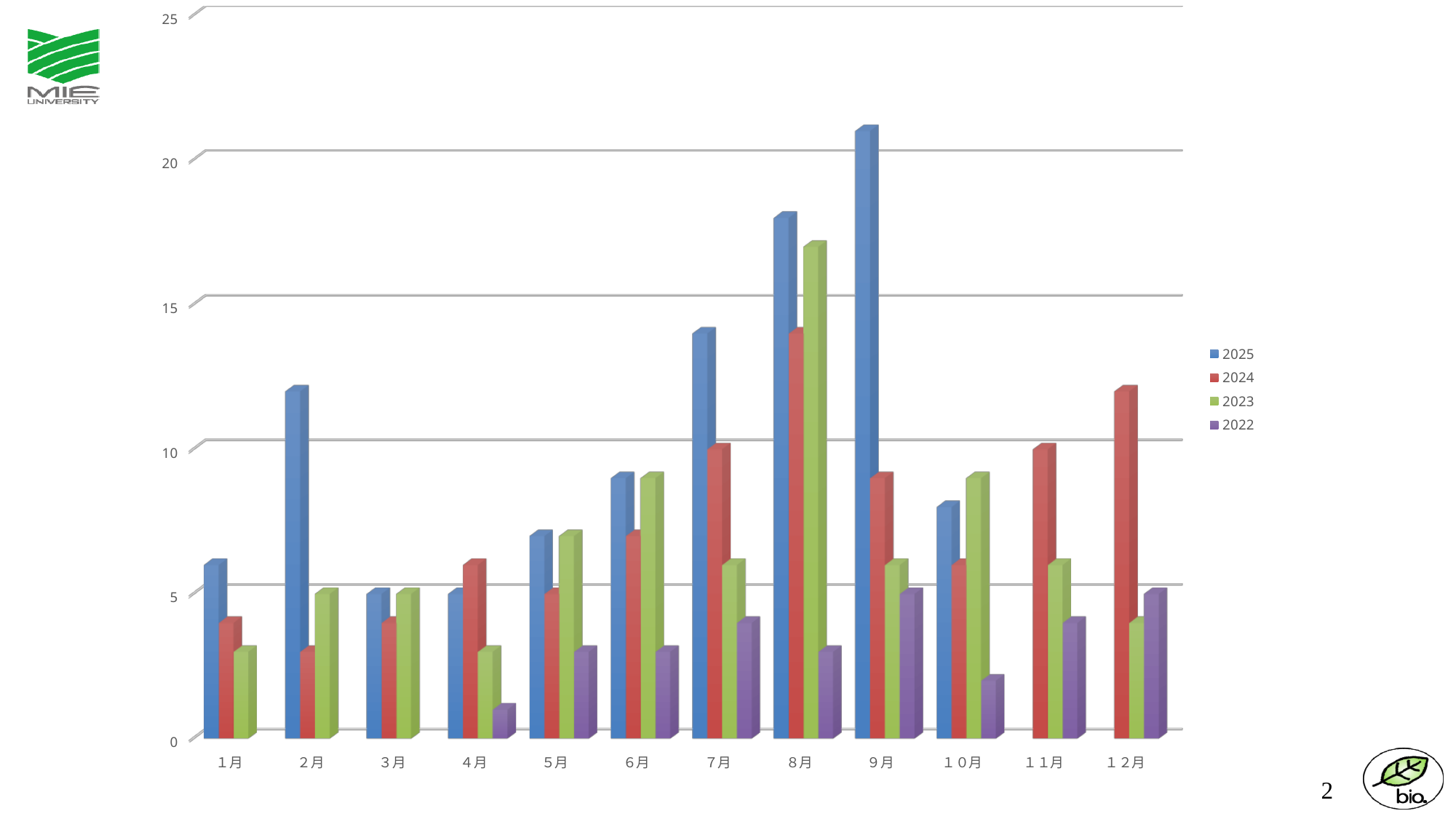
Is the value for 2025 in 9月 greater or less than 20? greater Which month has the highest value for the 2023 series? 8月 Which month has the highest value for the 2025 series? 9月 Is the value for 2022 in 10月 greater or less than 5? less In 2月, which series has the larger value, 2025 or 2024? 2025 Which month has the lowest value for the 2022 series? 4月 How many series does the legend list? 4 Is the value for 2024 in 12月 greater or less than 10? greater What kind of chart is shown on the slide? bar chart How many month categories are shown on the x axis? 12 Which series has no bars shown for 11月 and 12月? 2025